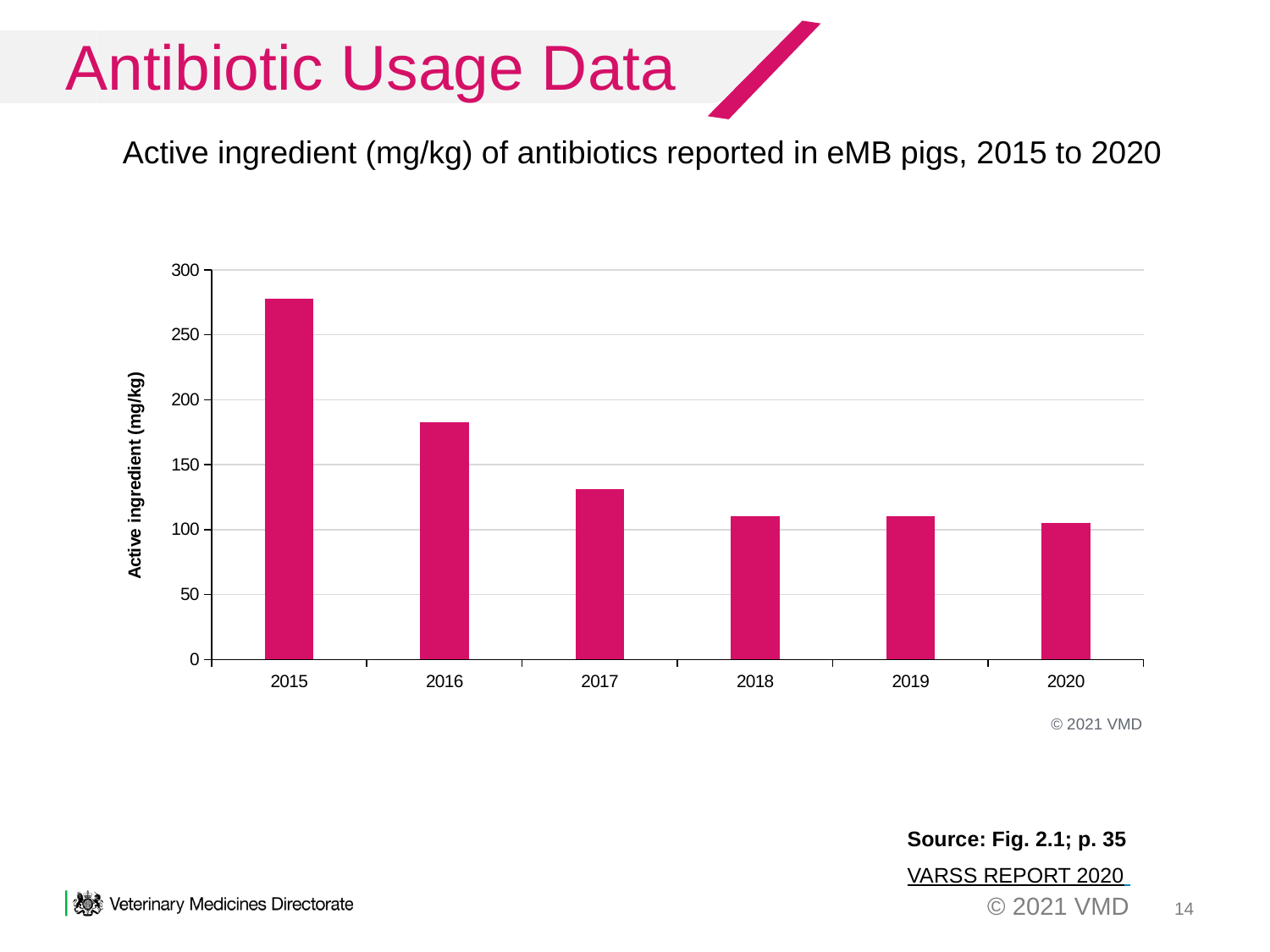
Is the value for 2020 greater or less than 100? greater Is the value for 2017 greater or less than 150? less How many years are plotted on the chart? 6 Is the value for 2016 greater or less than 200? less What kind of chart is shown on the slide? bar chart What is the label on the vertical axis of the chart? Active ingredient (mg/kg) What is the first year shown on the horizontal axis? 2015 Which is larger, the value for 2016 or the value for 2017? 2016 Do the values generally rise or fall from 2015 to 2020? fall Which year has the highest active ingredient value? 2015